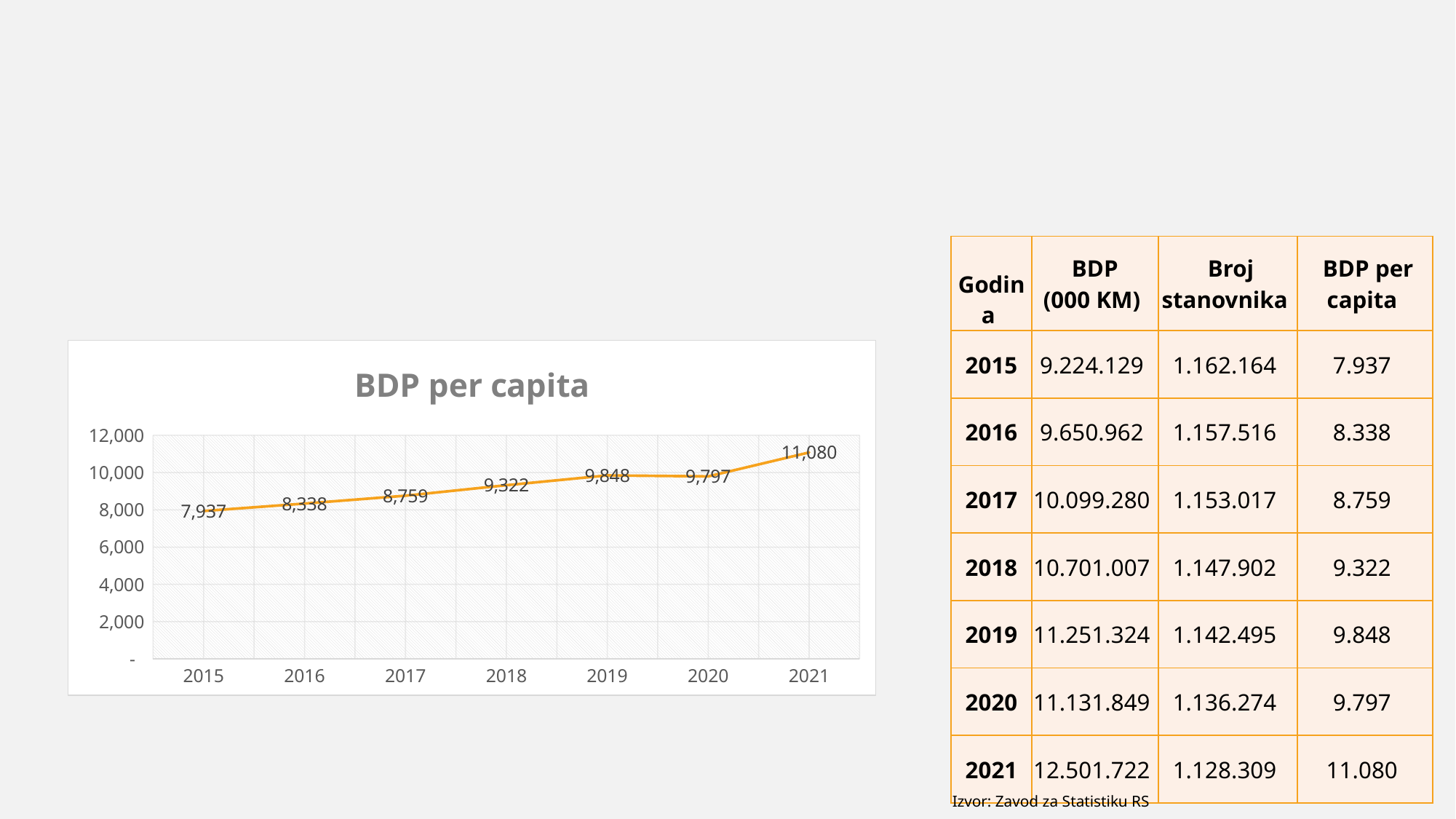
What is the value for 2018 in the BDP per capita chart? 9,322 Which year has the lowest value in the BDP per capita chart? 2015 In the BDP per capita chart, which is larger, the value for 2019 or the value for 2020? 2019 What is the difference between the 2021 and 2020 values in the BDP per capita chart? 1,283 Which year has the highest value in the BDP per capita chart? 2021 Is the value for 2017 in the BDP per capita chart greater or less than 8,000? greater What is the value for 2015 in the BDP per capita chart? 7,937 What is the value for 2020 in the BDP per capita chart? 9,797 What kind of chart is the BDP per capita chart? line chart What is the difference between the 2016 and 2015 values in the BDP per capita chart? 401 How many years are plotted in the BDP per capita chart? 7 Do the values in the BDP per capita chart generally rise or fall from 2015 to 2021? rise